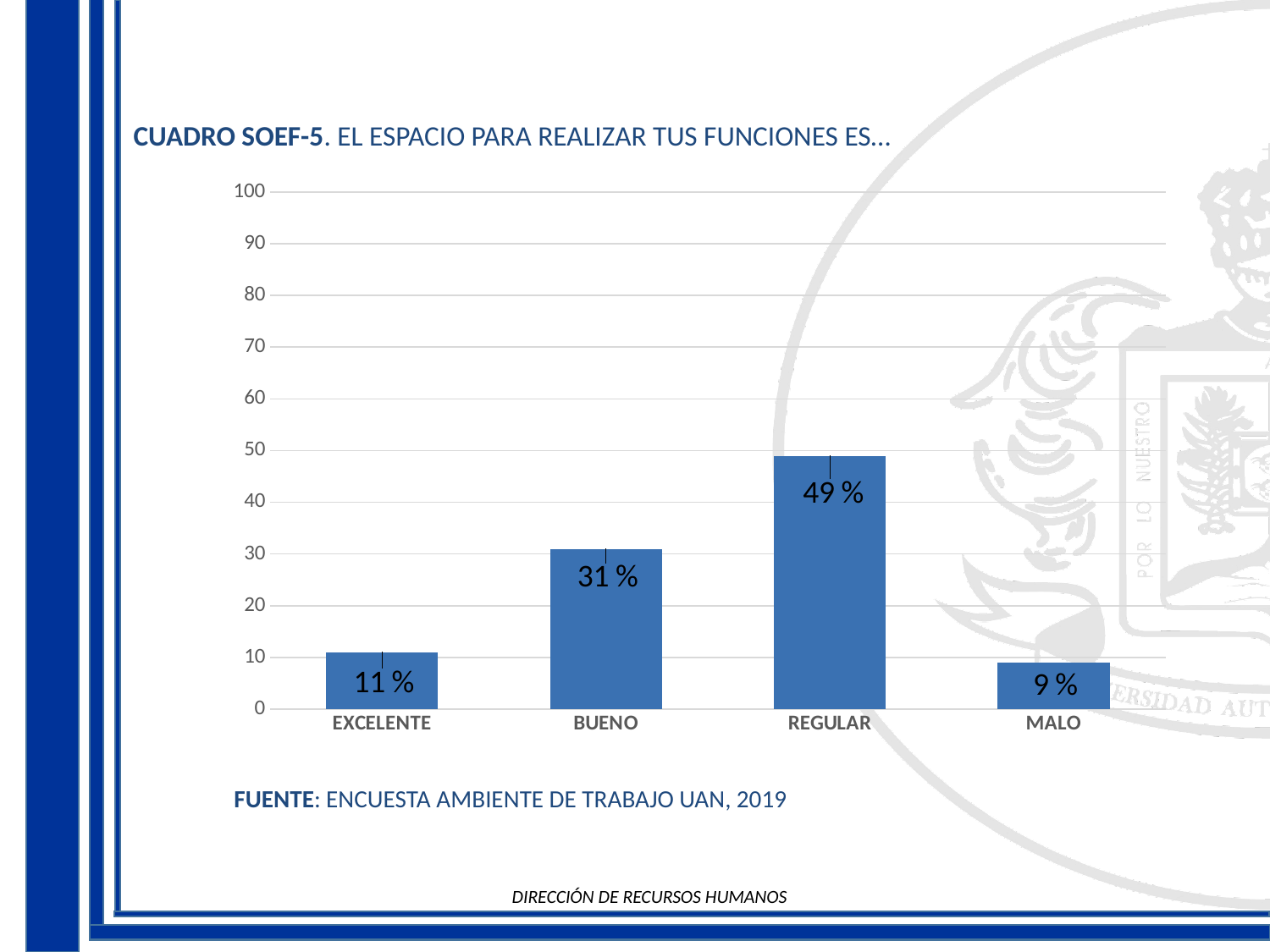
What kind of chart is shown on the slide? bar chart What is the source cited below the chart? ENCUESTA AMBIENTE DE TRABAJO UAN, 2019 What is the difference between the values for REGULAR and BUENO? 18 % Which category has the highest value? REGULAR What is the value for MALO? 9 % Which is larger, the value for EXCELENTE or the value for BUENO? BUENO Which category has the lowest value? MALO Is the value for REGULAR greater or less than 40? greater What is the value for BUENO? 31 % What is the value for REGULAR? 49 % What is the value for EXCELENTE? 11 % How many categories are shown on the x axis? 4